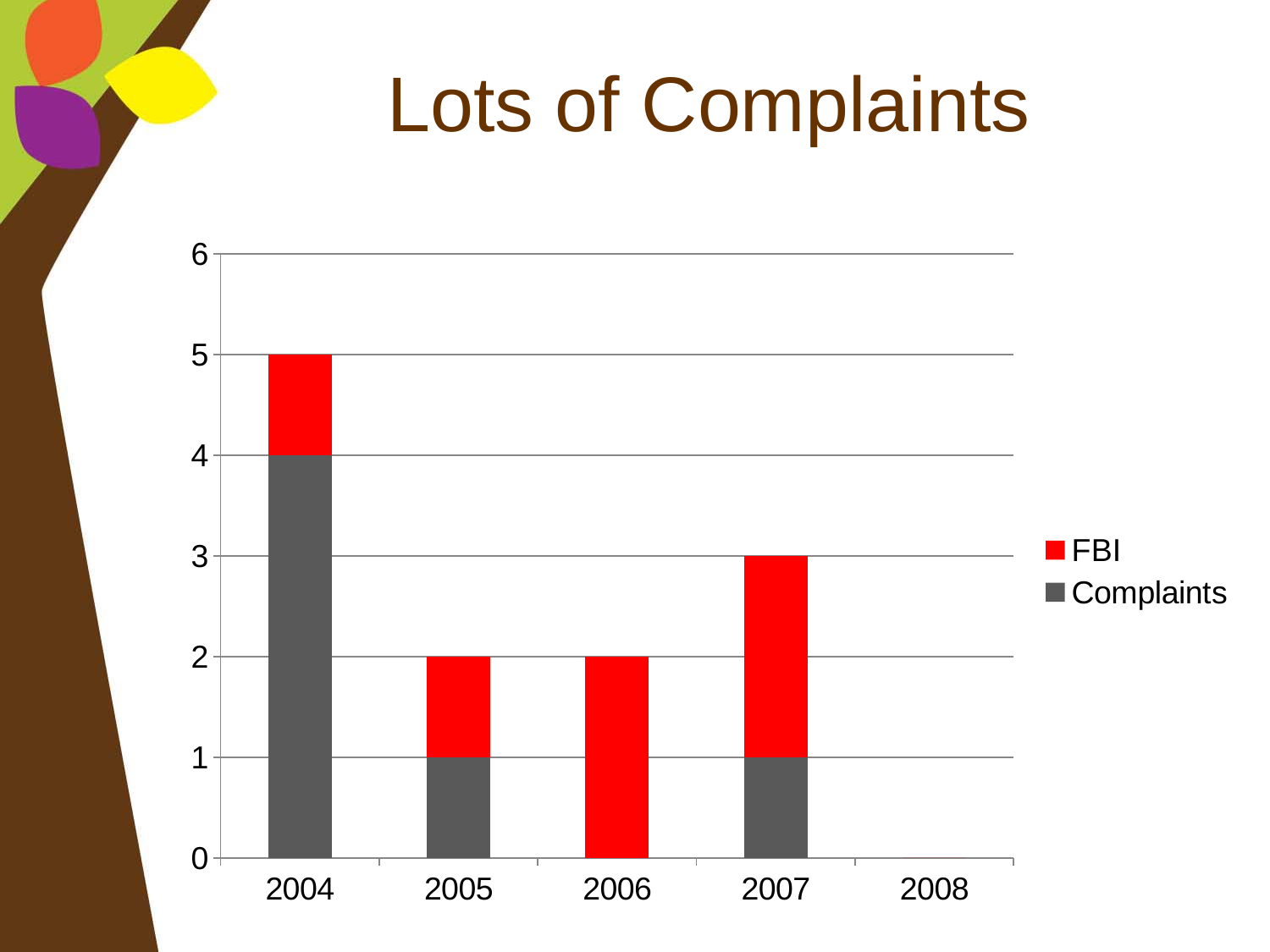
Which series is shown in red? FBI What is the Complaints value for 2007? 1 Which year has no bar at all? 2008 Which year has the tallest stacked bar? 2004 What is the total height of the stacked bar for 2004? 5 What is the difference between the Complaints values for 2004 and 2005? 3 What is the FBI value for 2006? 2 How many years are shown on the x axis? 5 What is the title of the chart? Lots of Complaints What is the Complaints value for 2004? 4 What kind of chart is shown on the slide? Stacked bar chart How many series does the legend list? 2